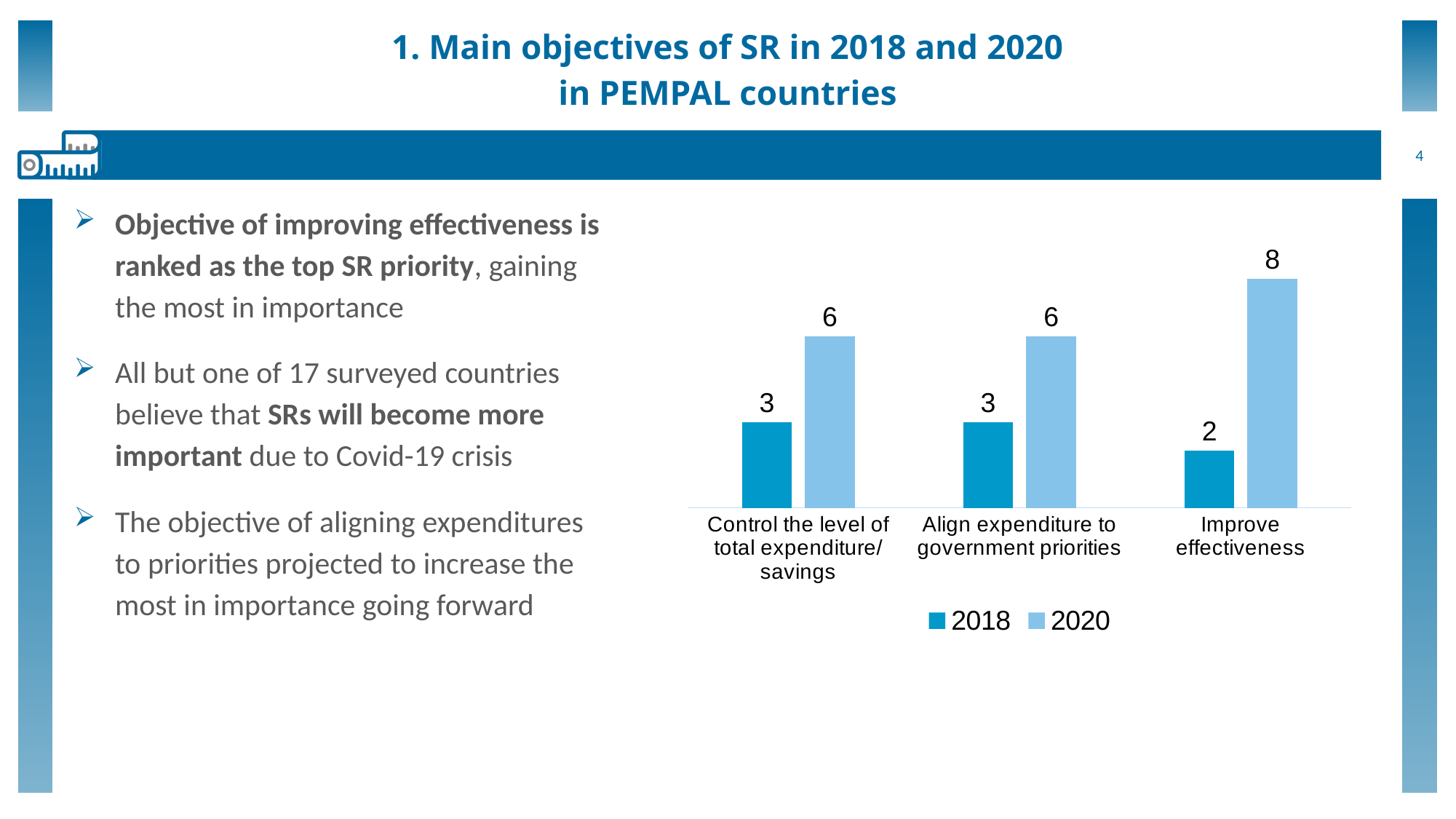
What kind of chart is shown on the slide? Bar chart Which is larger for Align expenditure to government priorities: the 2018 value or the 2020 value? 2020 Which category has the highest 2020 value? Improve effectiveness Which category has the lowest 2018 value? Improve effectiveness Which series is shown in the darker blue colour? 2018 How many categories are shown on the x axis? 3 What is the 2020 value for Improve effectiveness? 8 What is the difference between the 2020 and 2018 values for Improve effectiveness? 6 How many series does the legend list? 2 What is the 2018 value for Improve effectiveness? 2 What is the 2020 value for Align expenditure to government priorities? 6 What is the 2018 value for Control the level of total expenditure/savings? 3